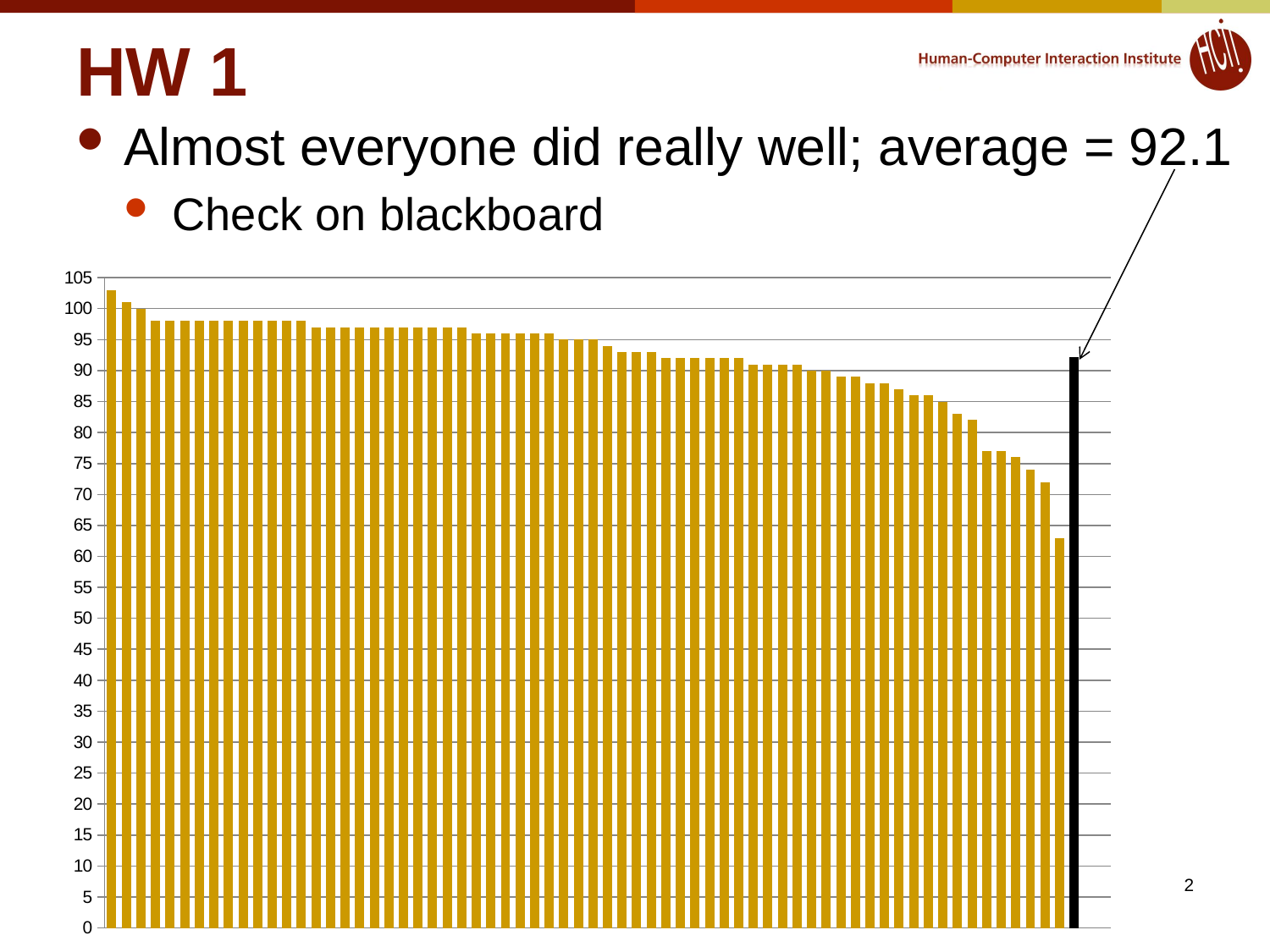
Do the gold bars rise or fall from left to right across the chart? fall Are the gold bars in the middle of the chart greater or less than 80? greater What value does the black bar at the right of the chart represent, according to the slide text? 92.1 Where is the shortest gold bar located in the chart? at the far right, just before the black bar Is the value of the rightmost gold bar greater or less than 70? less What is the highest value labelled on the vertical axis? 105 Is the value of the black bar greater or less than 90? greater What colour is the bar that represents the average? black Which bar is the tallest in the chart: the leftmost bar or the rightmost gold bar? the leftmost bar What kind of chart is shown on the slide? bar chart